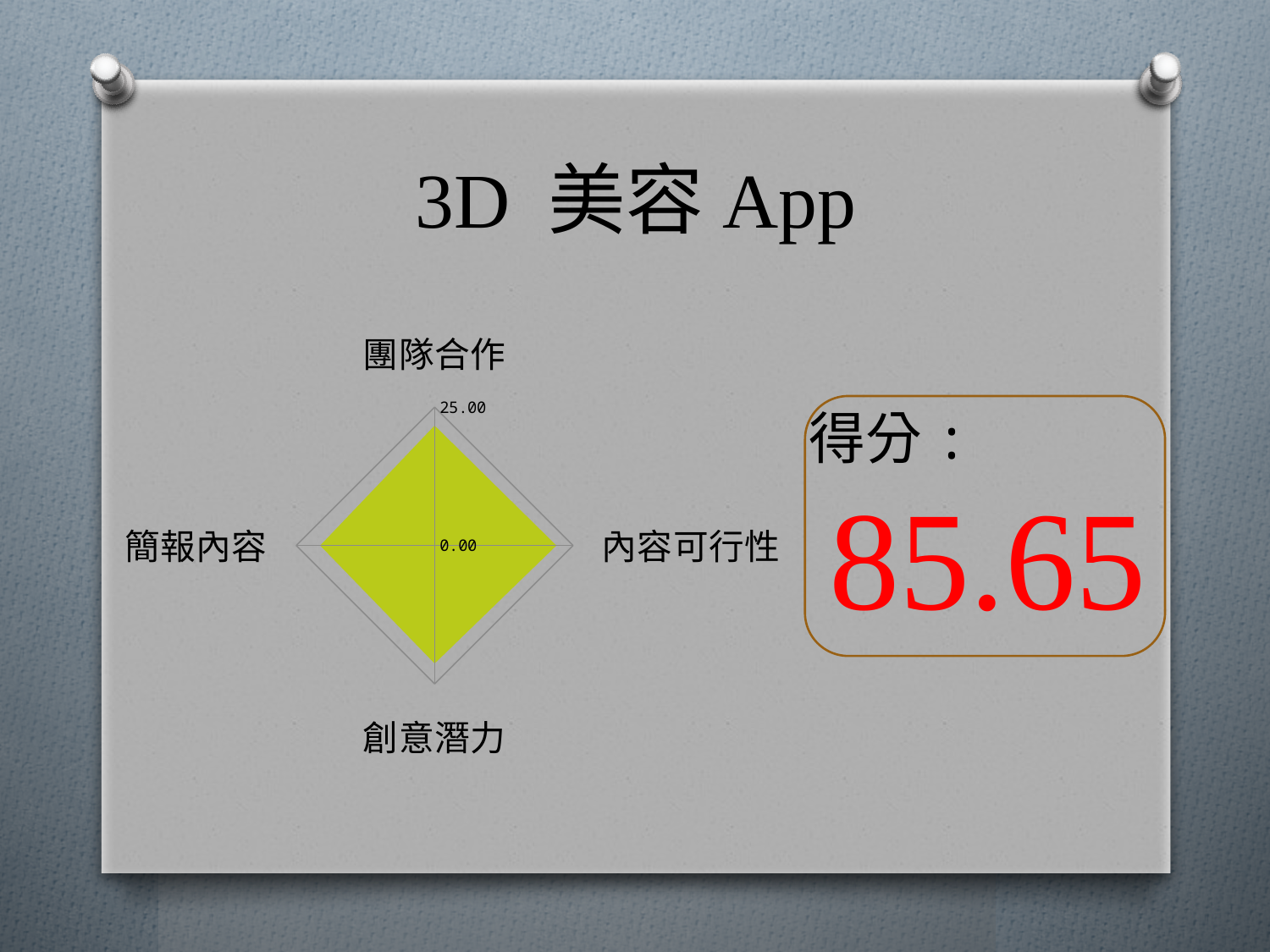
Is the value for 團隊合作 on the radar chart greater or less than 25.00? less What is the highest axis tick value shown on the radar chart? 25.00 How many categories (axes) does the radar chart have? 4 Which category label appears at the top of the radar chart? 團隊合作 What is the lowest axis tick value shown on the radar chart? 0.00 Is the value for 內容可行性 on the radar chart greater or less than 0.00? greater What kind of chart is shown on the slide? radar chart Is the value for 創意潛力 on the radar chart greater or less than 25.00? less